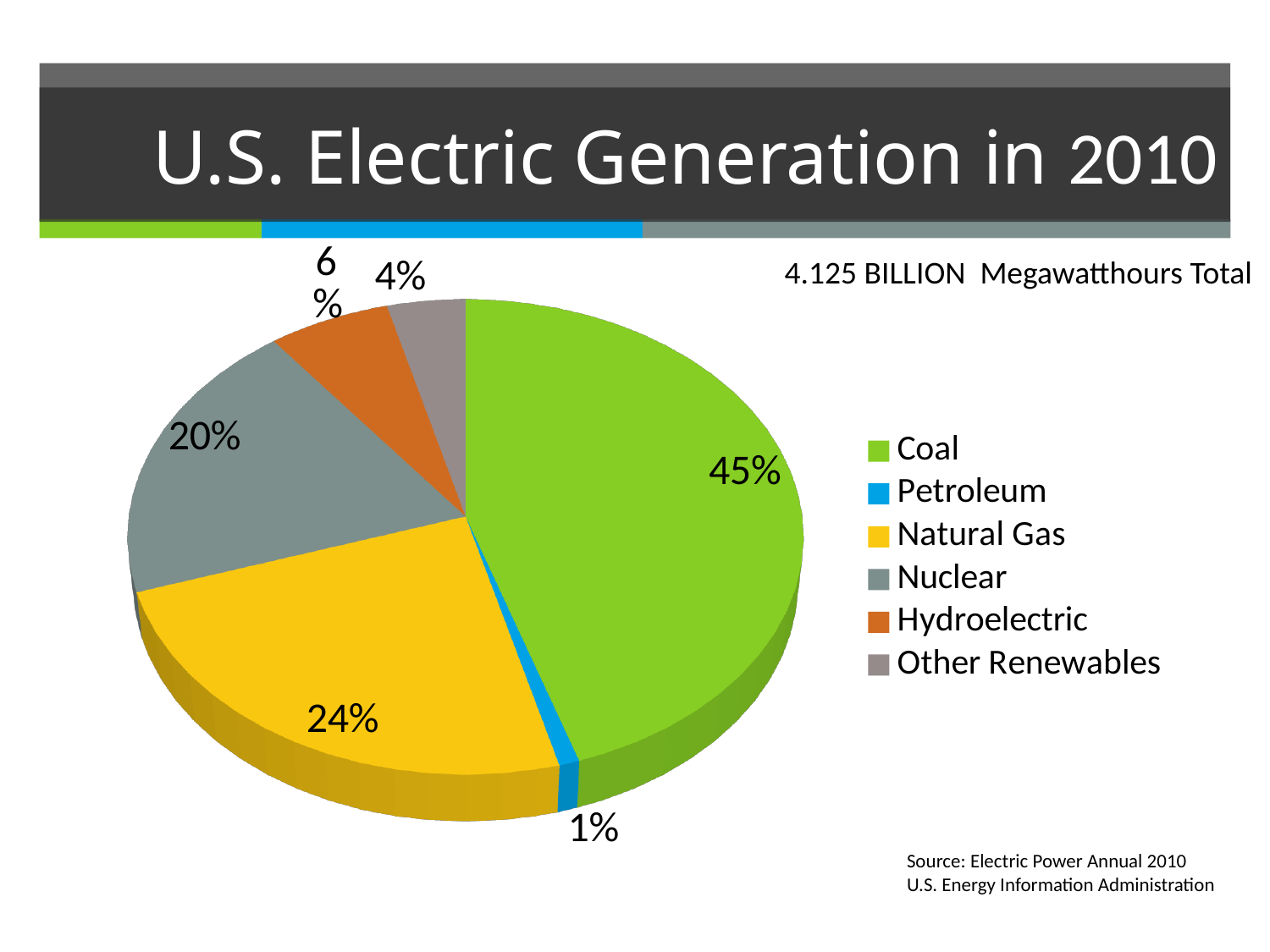
Which source has the smallest share of the pie? Petroleum How many categories does the legend list? 6 What kind of chart is shown on the slide? Pie chart What share of U.S. electric generation in 2010 came from Hydroelectric? 6% What share of U.S. electric generation in 2010 came from Coal? 45% What share of U.S. electric generation in 2010 came from Natural Gas? 24% Which has a larger share, Nuclear or Hydroelectric? Nuclear Which source has the largest share of the pie? Coal What total generation figure is stated on the slide? 4.125 BILLION Megawatthours What share of U.S. electric generation in 2010 came from Petroleum? 1% How many percentage points larger is the Coal share than the Natural Gas share? 21 What share of U.S. electric generation in 2010 came from Nuclear? 20%